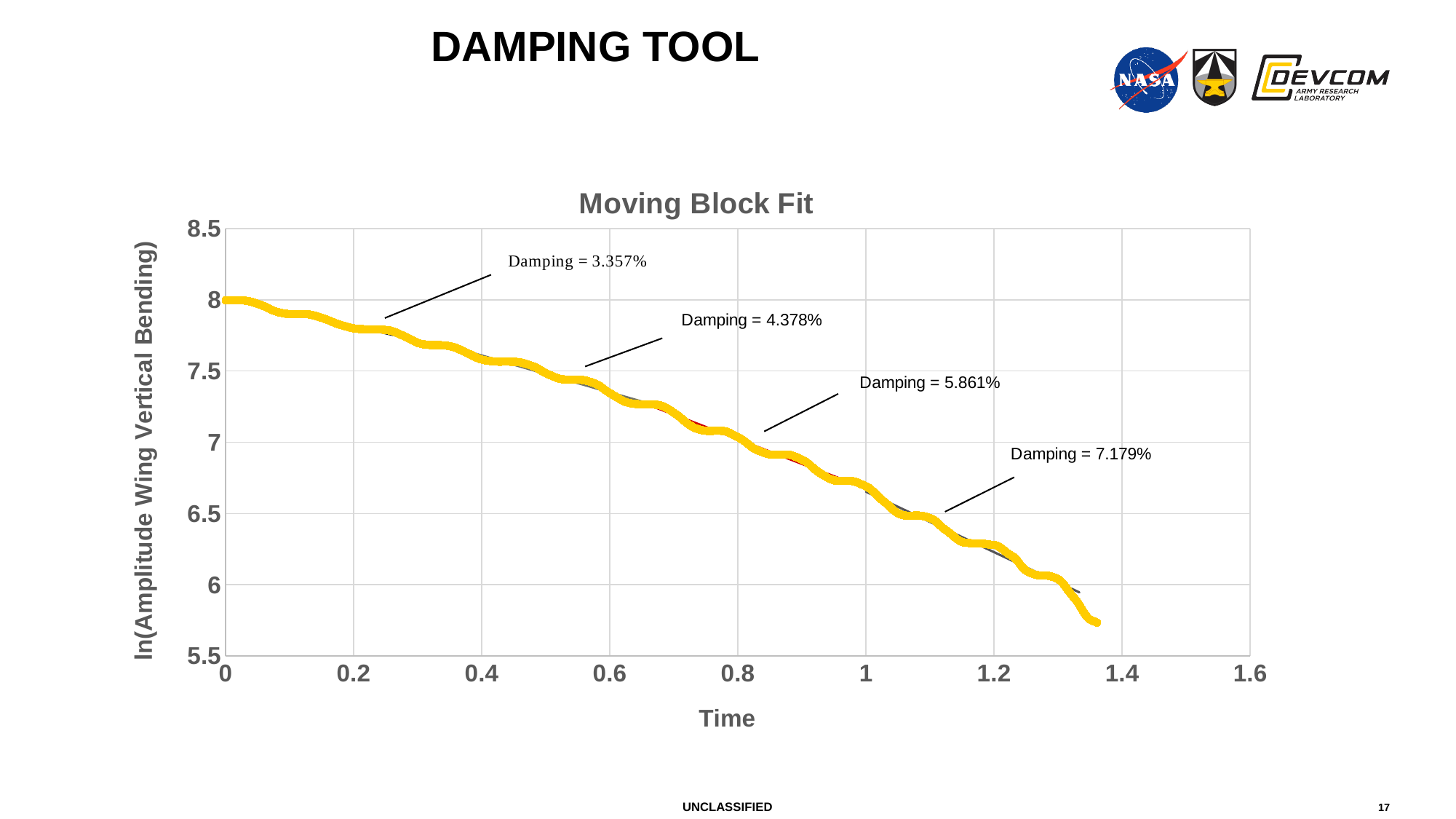
What is the difference between the highest and lowest annotated damping values? 3.822% Which annotated damping value is the highest? 7.179% How many damping values are annotated on the chart? 4 Which annotated damping value is the lowest? 3.357% What is the damping value annotated near Time 1.1? Damping = 7.179% Is the plotted value at Time 1 greater or less than 7? less What kind of chart is shown under the title "Moving Block Fit"? line chart What is the title of the chart? Moving Block Fit Does the plotted line rise or fall as Time increases? fall What is the label of the x axis? Time Is the plotted value at Time 0.2 greater or less than 7.5? greater What is the first damping value annotated on the chart (nearest Time 0.2)? Damping = 3.357%